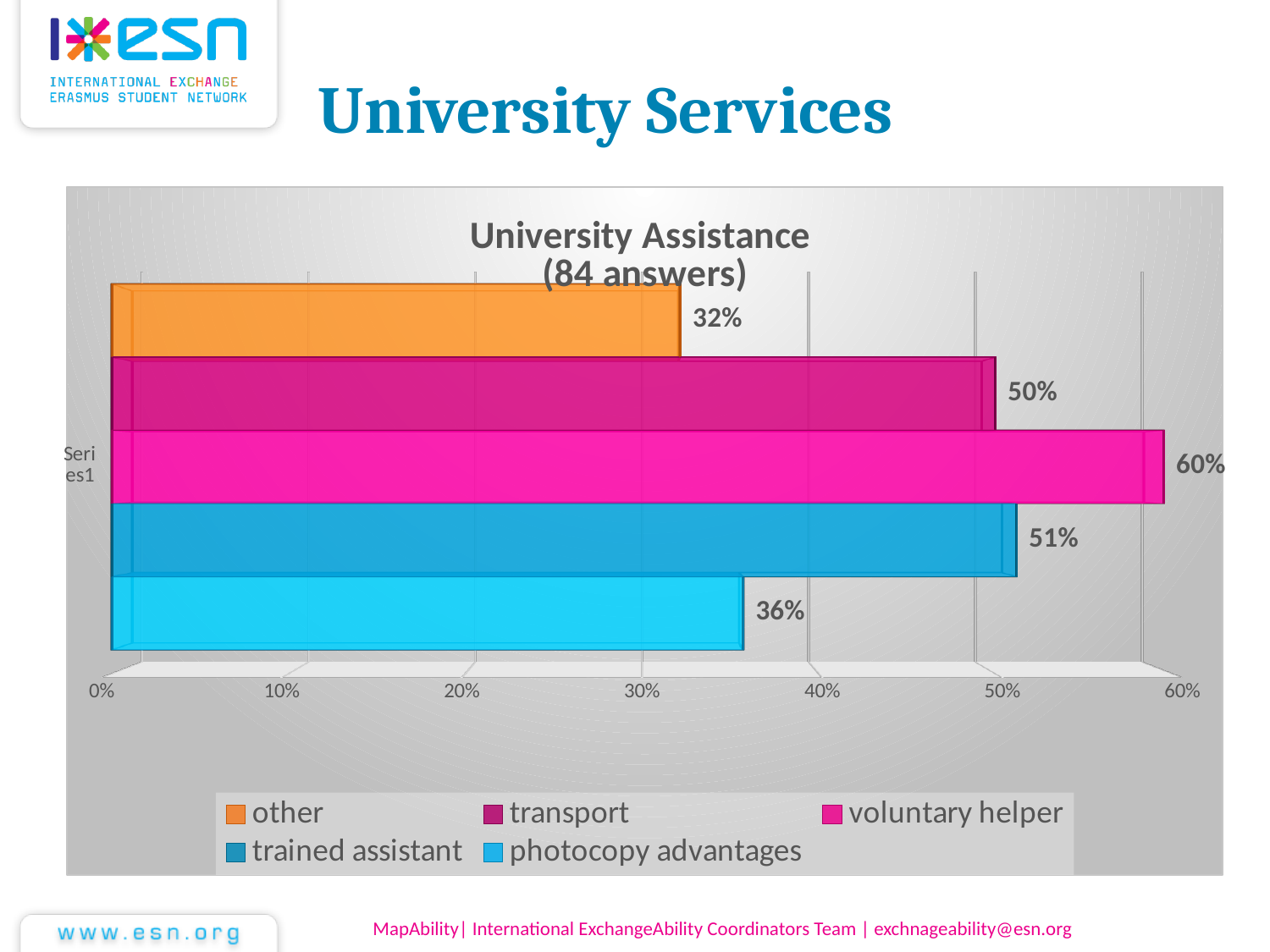
What is the value for photocopy advantages in the University Assistance chart? 36% Which legend entry has the highest value in the University Assistance chart? voluntary helper What kind of chart is shown on the slide? bar chart How many entries does the legend of the University Assistance chart list? 5 What is the difference between the values for voluntary helper and other in the University Assistance chart? 28% What is the value for trained assistant in the University Assistance chart? 51% How many answers does the chart title say the University Assistance data is based on? 84 What is the value for transport in the University Assistance chart? 50% Which legend entry has the lowest value in the University Assistance chart? other What is the value for voluntary helper in the University Assistance chart? 60% Which is larger in the University Assistance chart, the value for photocopy advantages or the value for other? photocopy advantages What colour is the bar for other in the University Assistance chart? orange